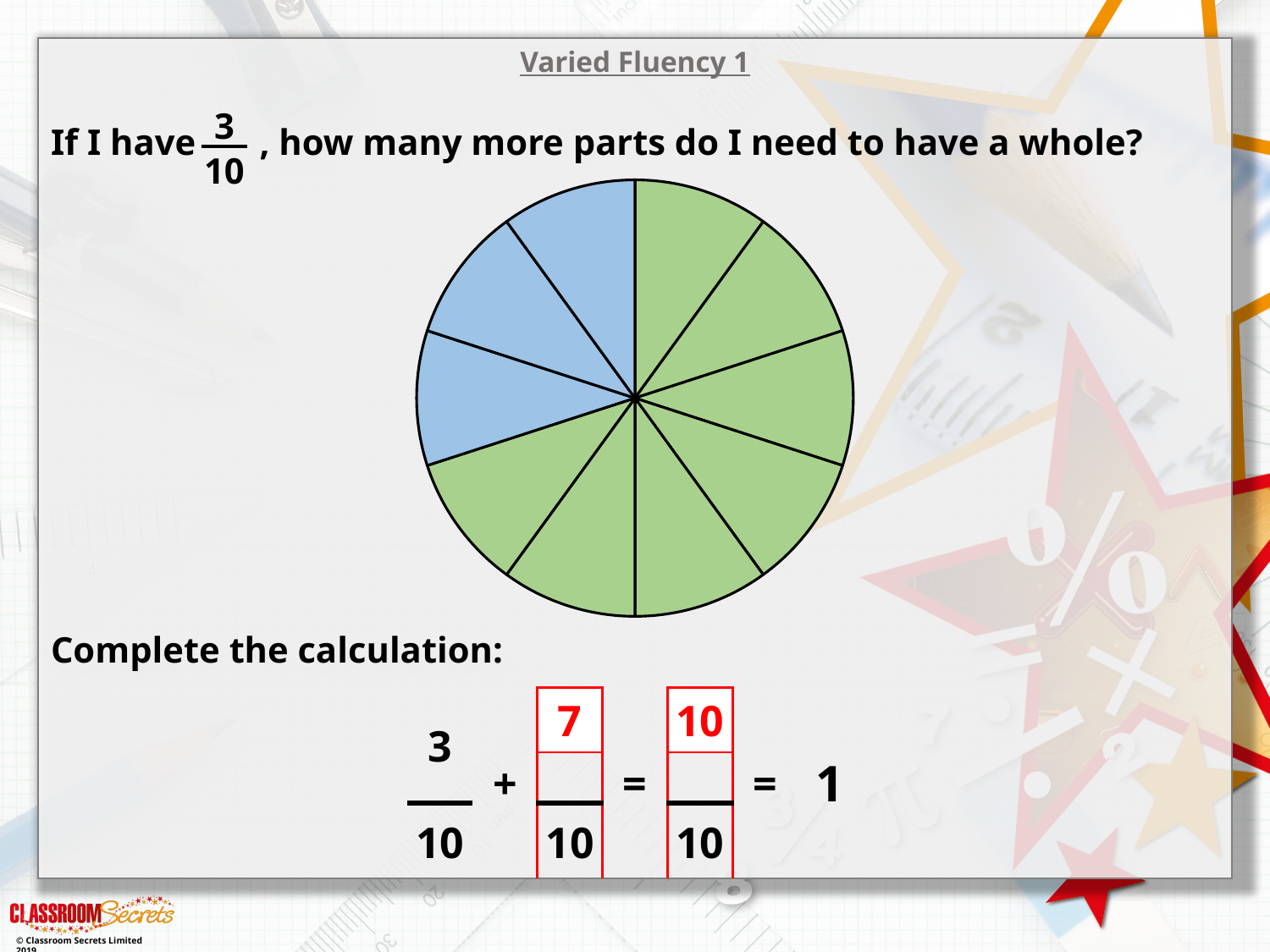
What is the total of 3/10 and 7/10 as shown in the calculation? 1 What fraction of the circle is shaded green? 7/10 According to the completed calculation, how many more parts are needed to make a whole from 3/10? 7 How many parts of the circle are shaded blue? 3 What is the title at the top of the slide? Varied Fluency 1 What fraction of the circle is shaded blue? 3/10 Which colour covers more of the circle, blue or green? green What kind of chart is shown on the slide? pie chart How many parts of the circle are shaded green? 7 What fraction is shown in the second red box of the calculation? 10/10 How many more green parts are there than blue parts? 4 How many equal parts is the circle divided into? 10